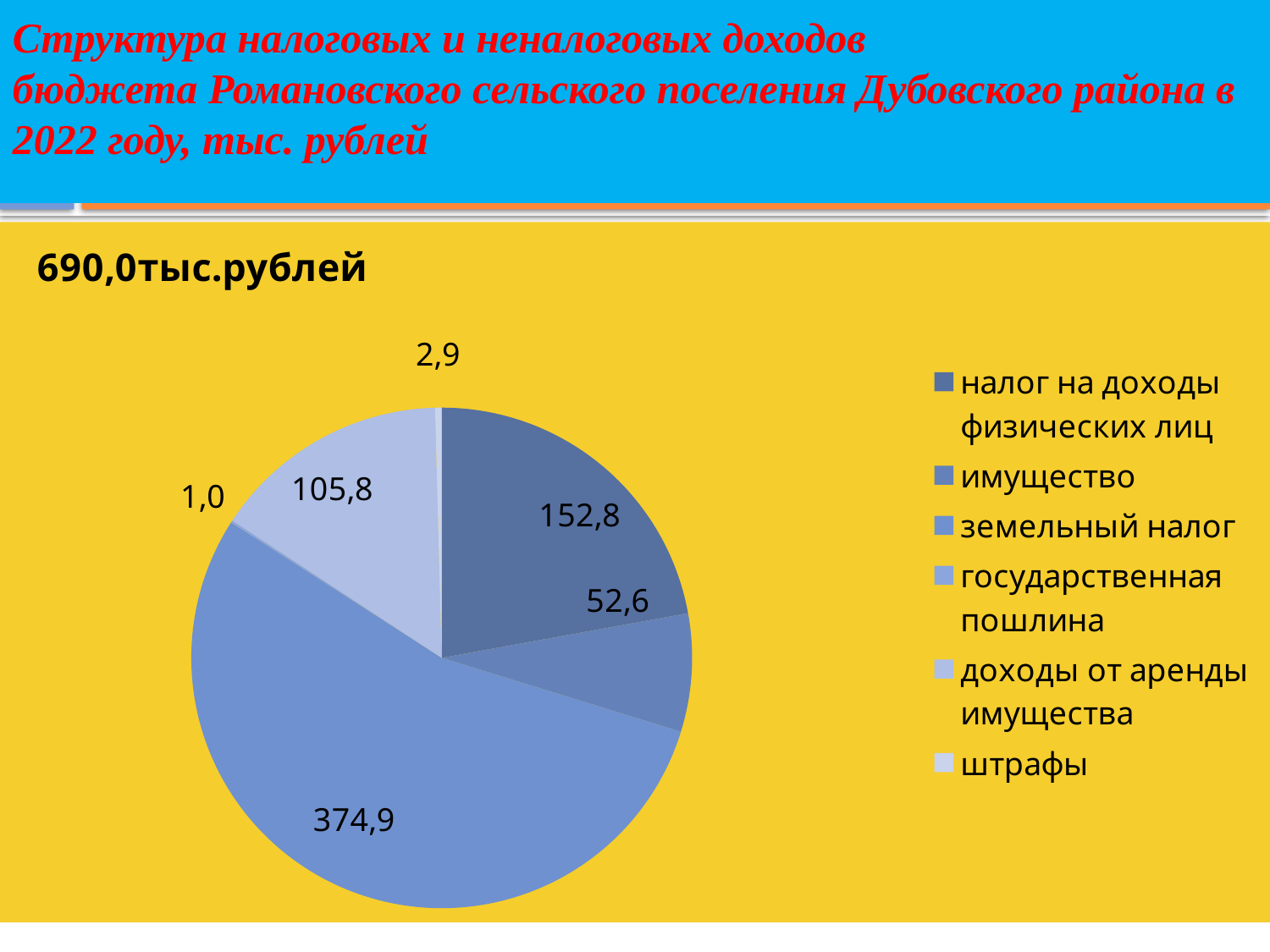
How many categories does the legend list? 6 What is the value for земельный налог? 374,9 What is the value for штрафы? 2,9 Which category has the smallest slice of the pie? государственная пошлина What type of chart is shown on the slide? pie chart What is the value for доходы от аренды имущества? 105,8 What total amount in тыс. рублей is stated above the chart? 690,0тыс.рублей Which is larger, the value for имущество or the value for доходы от аренды имущества? доходы от аренды имущества Which category has the largest slice of the pie? земельный налог What is the difference between the values for земельный налог and налог на доходы физических лиц? 222,1 What is the value for имущество? 52,6 What is the value for налог на доходы физических лиц? 152,8